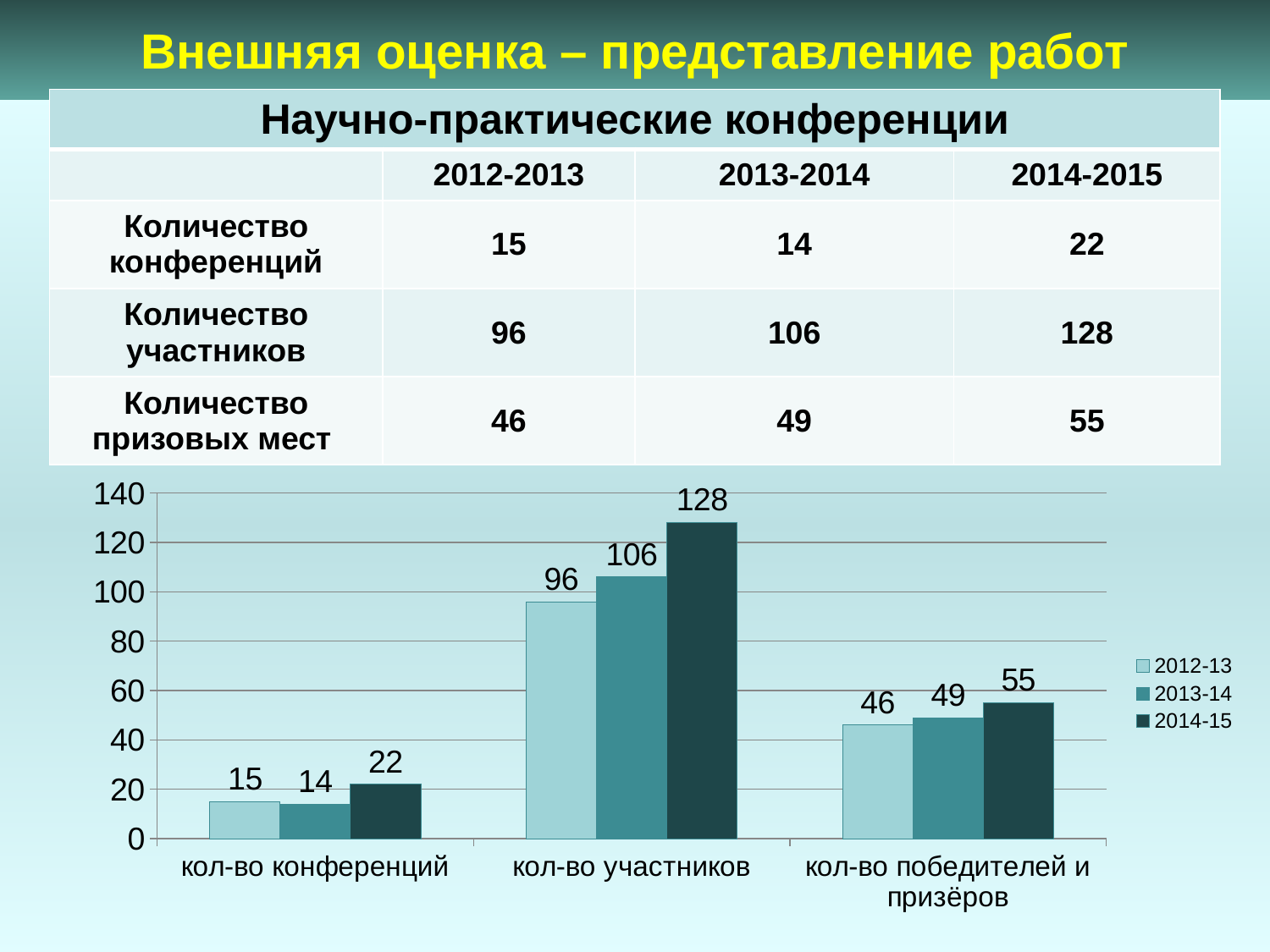
Is the value for 2014-15 in the кол-во победителей и призёров category greater or less than 60? less What is the value for 2013-14 in the кол-во победителей и призёров category? 49 What is the difference between the 2014-15 and 2012-13 values in the кол-во участников category? 32 How many series does the chart legend list? 3 Which category has the lowest value for the 2012-13 series? кол-во конференций What kind of chart is shown on the slide? bar chart How many categories are shown on the x axis of the chart? 3 What is the value for 2012-13 in the кол-во конференций category? 15 Do the values in the кол-во участников category rise or fall from 2012-13 to 2014-15? rise Which is larger in the кол-во конференций category: the 2012-13 value or the 2013-14 value? 2012-13 Which category has the highest value for the 2014-15 series? кол-во участников What is the value for 2014-15 in the кол-во участников category? 128